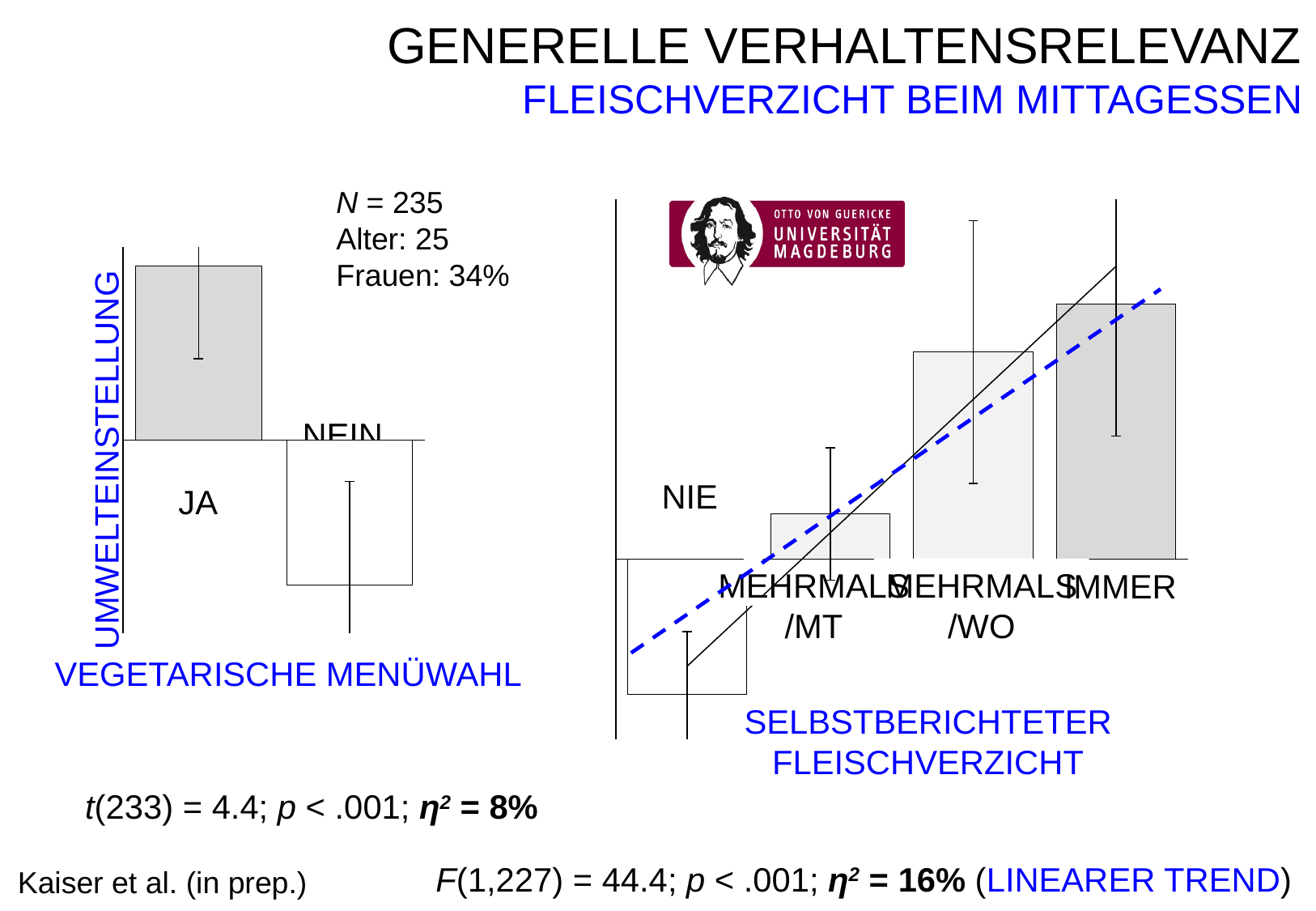
In the right chart (SELBSTBERICHTETER FLEISCHVERZICHT), which bar is higher, MEHRMALS/MT or MEHRMALS/WO? MEHRMALS/WO What kind of chart is the right chart (SELBSTBERICHTETER FLEISCHVERZICHT)? bar chart What kind of chart is the left chart (VEGETARISCHE MENÜWAHL)? bar chart In the right chart (SELBSTBERICHTETER FLEISCHVERZICHT), do the bar values rise or fall from NIE to IMMER? rise What is the y-axis label of the left chart? UMWELTEINSTELLUNG How many categories are shown in the right chart (SELBSTBERICHTETER FLEISCHVERZICHT)? 4 How many categories are shown in the left chart (VEGETARISCHE MENÜWAHL)? 2 In the left chart (VEGETARISCHE MENÜWAHL), which category has the lowest value? NEIN In the right chart (SELBSTBERICHTETER FLEISCHVERZICHT), which category has the lowest bar? NIE In the right chart (SELBSTBERICHTETER FLEISCHVERZICHT), which category has the highest bar? IMMER In the left chart (VEGETARISCHE MENÜWAHL), which category has the higher bar, JA or NEIN? JA What is the x-axis label of the right chart? SELBSTBERICHTETER FLEISCHVERZICHT